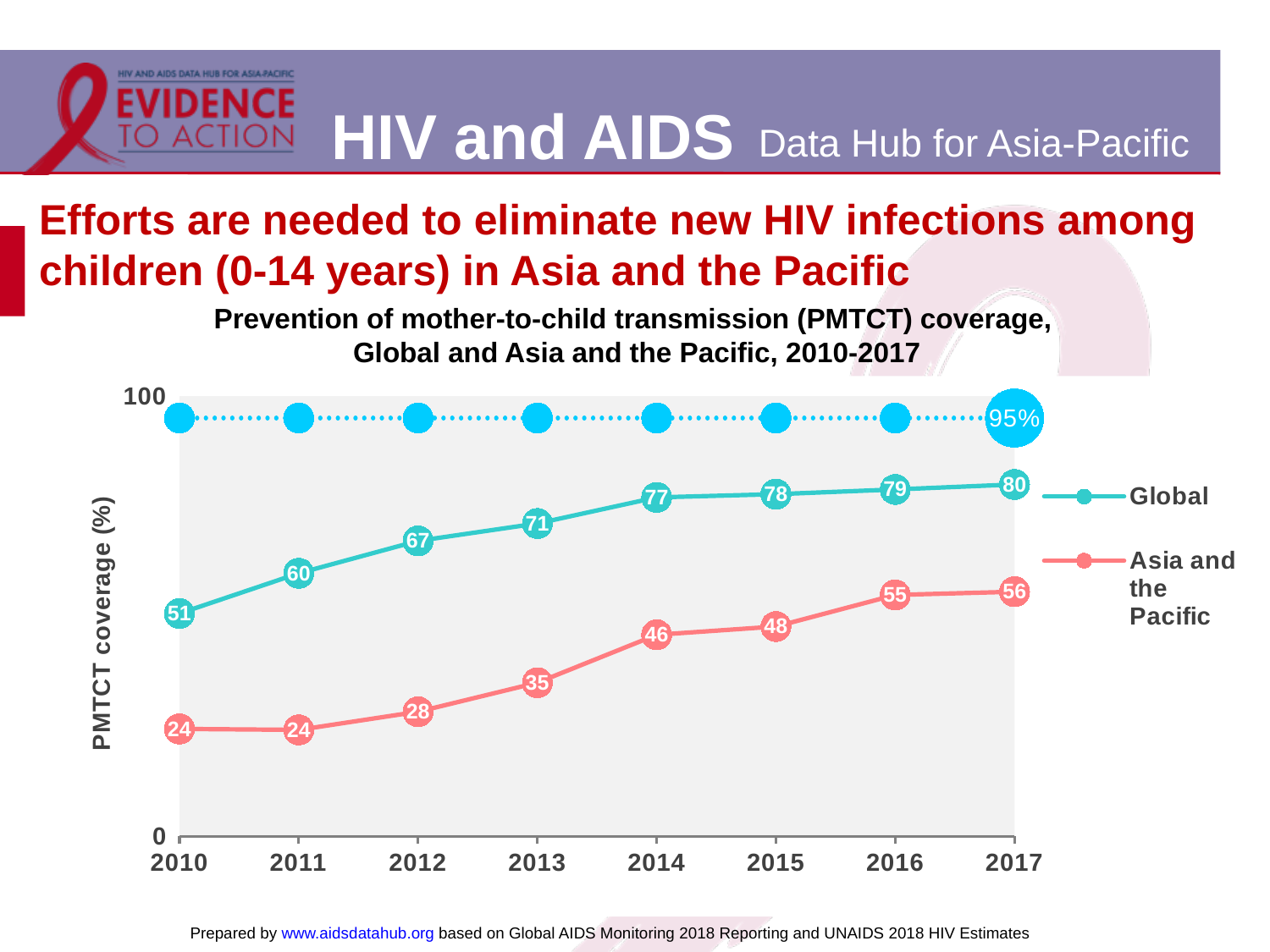
What is the Asia and the Pacific PMTCT coverage value in 2017? 56 In which year is the Global PMTCT coverage highest? 2017 Does the Asia and the Pacific series rise or fall from 2010 to 2017? Rise What is the lowest value shown for the Asia and the Pacific series? 24 How many years are shown on the x axis? 8 What target value is marked by the dotted line at the top of the chart? 95% What kind of chart is shown on the slide? Line chart Which series has the larger value in 2016, Global or Asia and the Pacific? Global What is the difference between the Global and Asia and the Pacific values in 2014? 31 What is the Global PMTCT coverage value in 2010? 51 What is the Asia and the Pacific PMTCT coverage value in 2013? 35 How many series does the legend list? 2